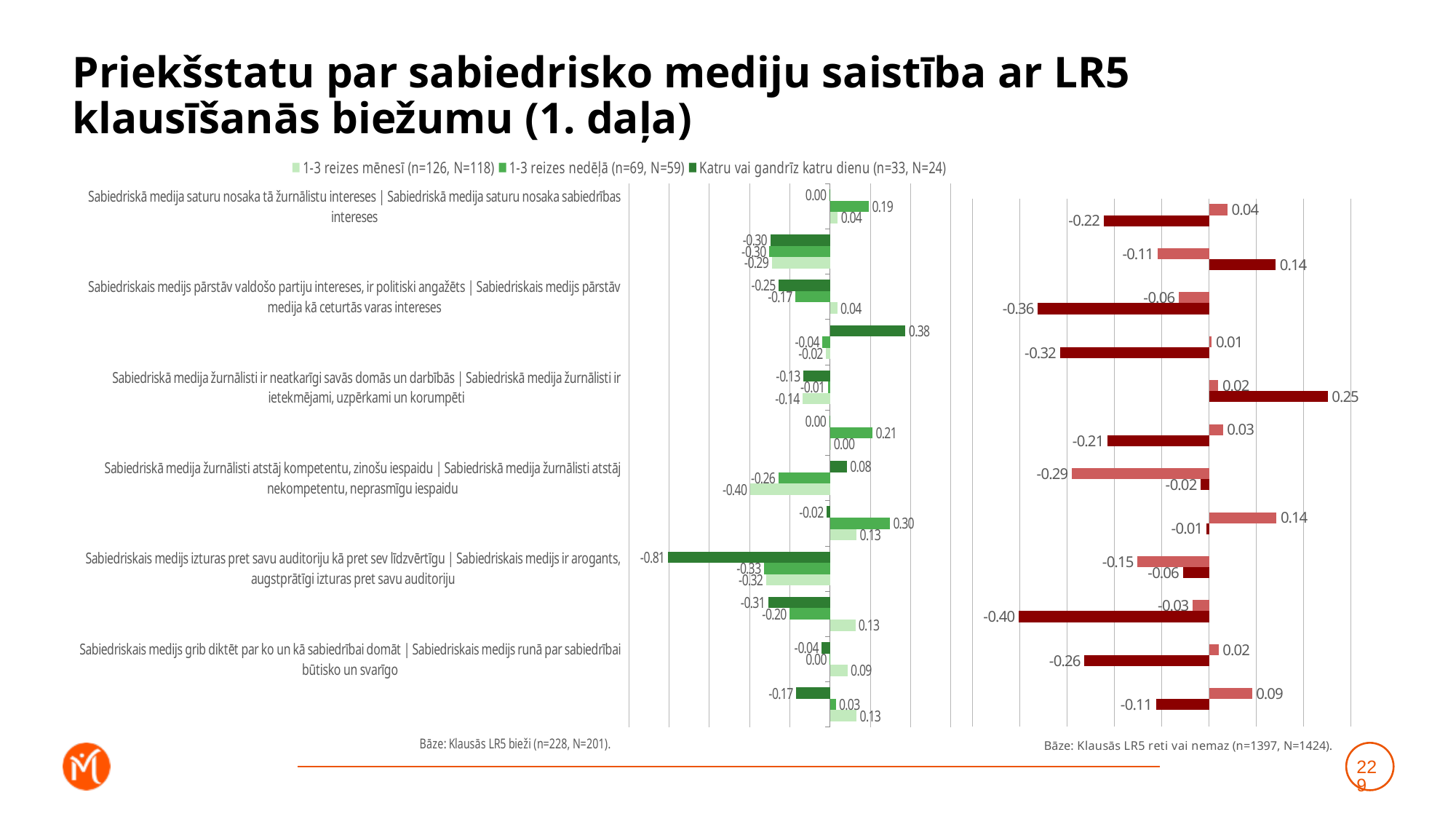
How many series does the legend at the top of the slide list? 3 How many groups of bars are plotted in the left (green) chart? 12 Which legend series does the dark green colour represent? Katru vai gandrīz katru dienu (n=33, N=24) In the right (red) chart, what is the lowest value shown? -0.40 In the left (green) chart, what is the highest value shown? 0.38 What is the difference between the highest value in the left (green) chart (0.38) and the highest value in the right (red) chart (0.25)? 0.13 What kind of chart is shown on the left side of the slide? bar chart In the left (green) chart, what is the lowest value shown? -0.81 In the right (red) chart, what is the highest value shown? 0.25 What base note is printed under the right (red) chart? Bāze: Klausās LR5 reti vai nemaz (n=1397, N=1424). Which is larger: the highest value in the left (green) chart or the highest value in the right (red) chart? the left (green) chart